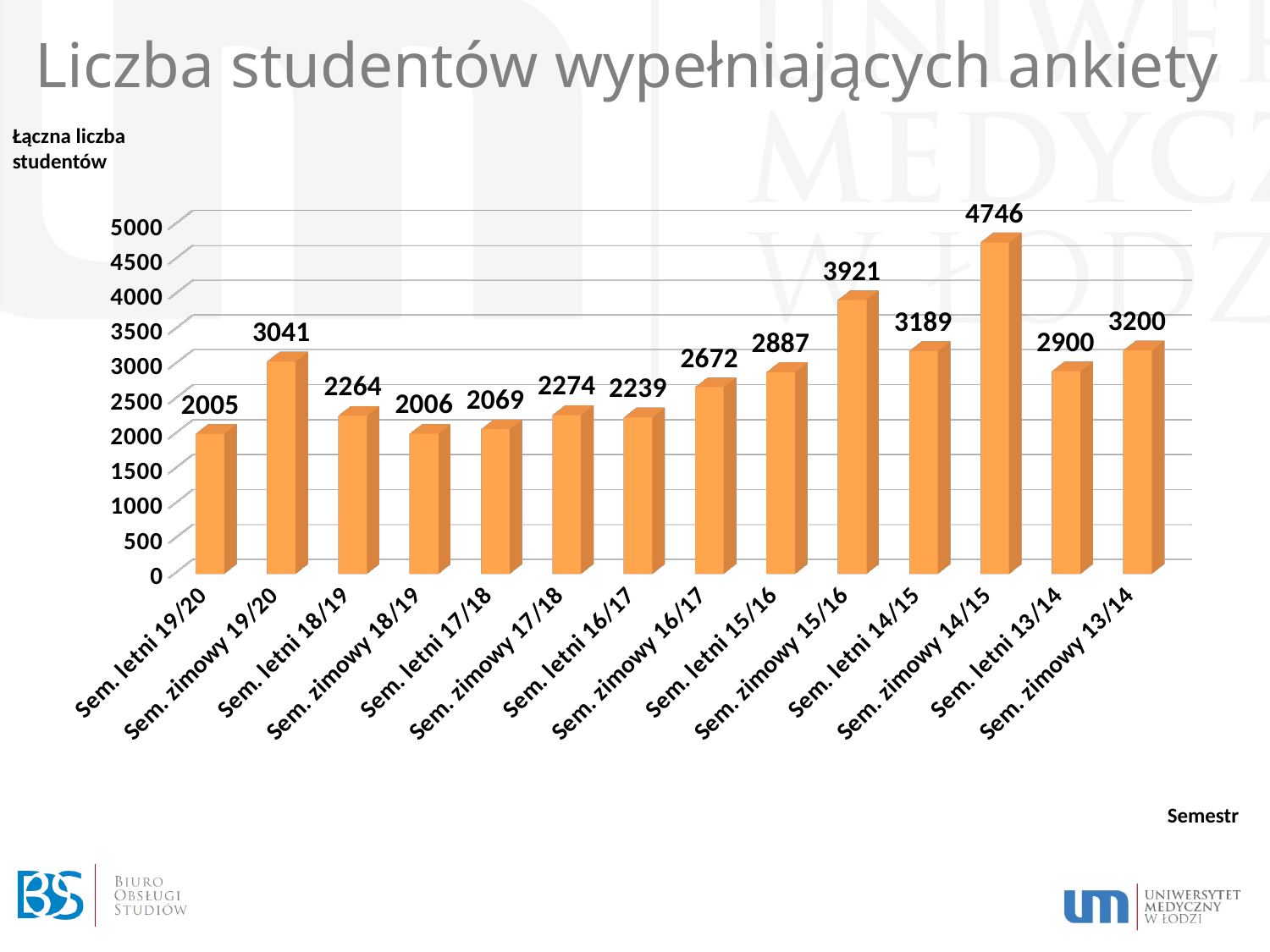
Which is larger, the value for Sem. letni 14/15 or Sem. zimowy 16/17? Sem. letni 14/15 Which semester has the lowest number of students? Sem. letni 19/20 What kind of chart is shown on the slide? bar chart What is the value for Sem. zimowy 13/14? 3200 What is the value for Sem. letni 15/16? 2887 What is the difference between the values for Sem. zimowy 14/15 and Sem. zimowy 15/16? 825 What is the value for Sem. zimowy 19/20? 3041 How many semesters are shown on the chart? 14 What is the title of the slide? Liczba studentów wypełniających ankiety Which semester has the highest number of students? Sem. zimowy 14/15 Is the value for Sem. zimowy 15/16 greater or less than 3500? greater What is the difference between the values for Sem. zimowy 13/14 and Sem. letni 13/14? 300